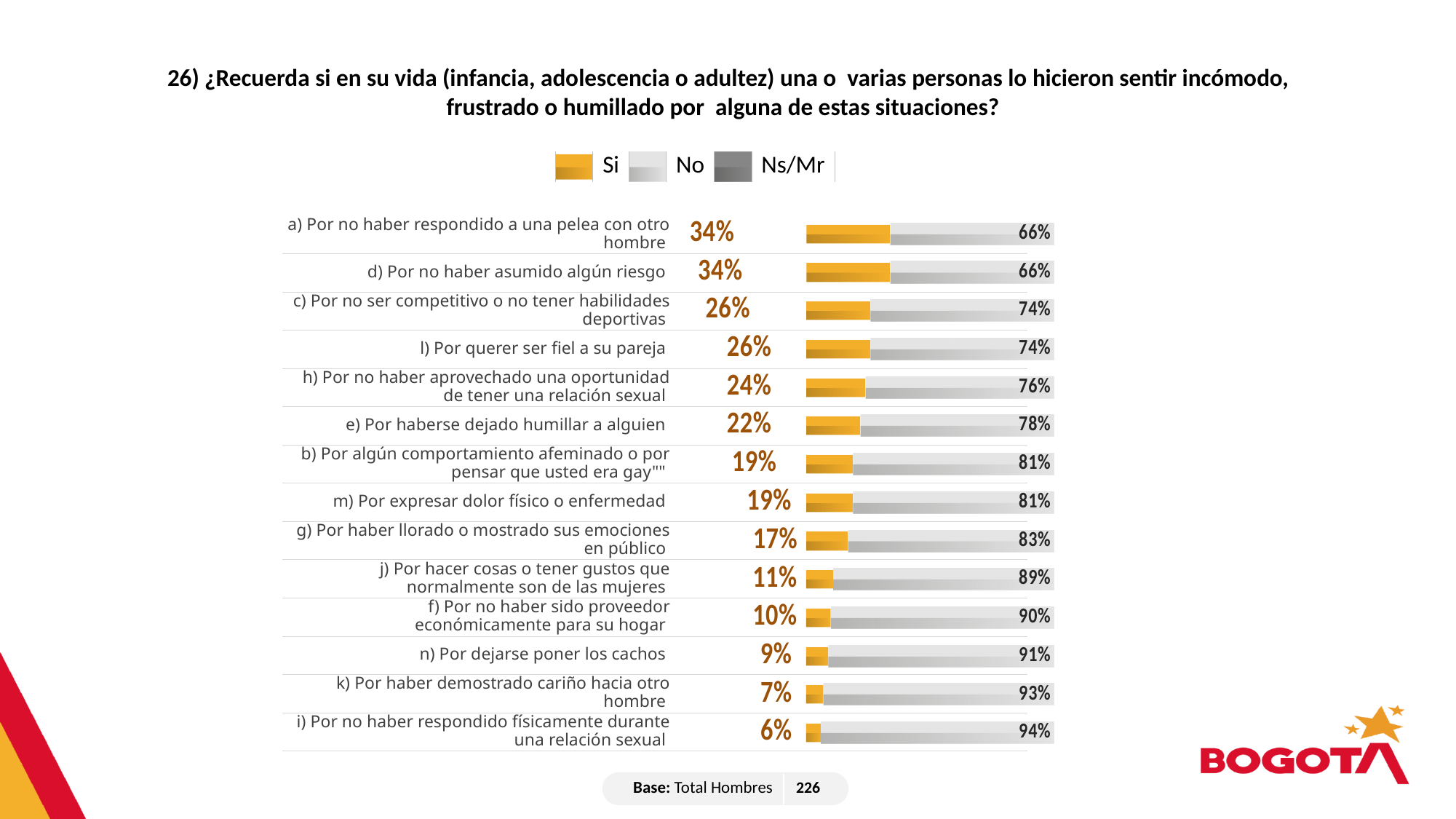
Which category has the lowest "Si" percentage? i) Por no haber respondido físicamente durante una relación sexual What kind of chart is shown on the slide? Stacked bar chart How many categories (situations) are shown in the chart? 14 What percentage of respondents answered "Si" for "d) Por no haber asumido algún riesgo"? 34% How many series does the legend list? 3 Which has a larger "Si" value: "h) Por no haber aprovechado una oportunidad de tener una relación sexual" or "j) Por hacer cosas o tener gustos que normalmente son de las mujeres"? h) Por no haber aprovechado una oportunidad de tener una relación sexual Which category has the highest "No" percentage? i) Por no haber respondido físicamente durante una relación sexual What is the base (number of respondents) shown below the chart? 226 What is the "Si" value for "n) Por dejarse poner los cachos"? 9% What is the difference between the "Si" values for "a) Por no haber respondido a una pelea con otro hombre" and "g) Por haber llorado o mostrado sus emociones en público"? 17% What percentage answered "No" for "e) Por haberse dejado humillar a alguien"? 78% What is the total of the "Si" and "No" values for "k) Por haber demostrado cariño hacia otro hombre"? 100%